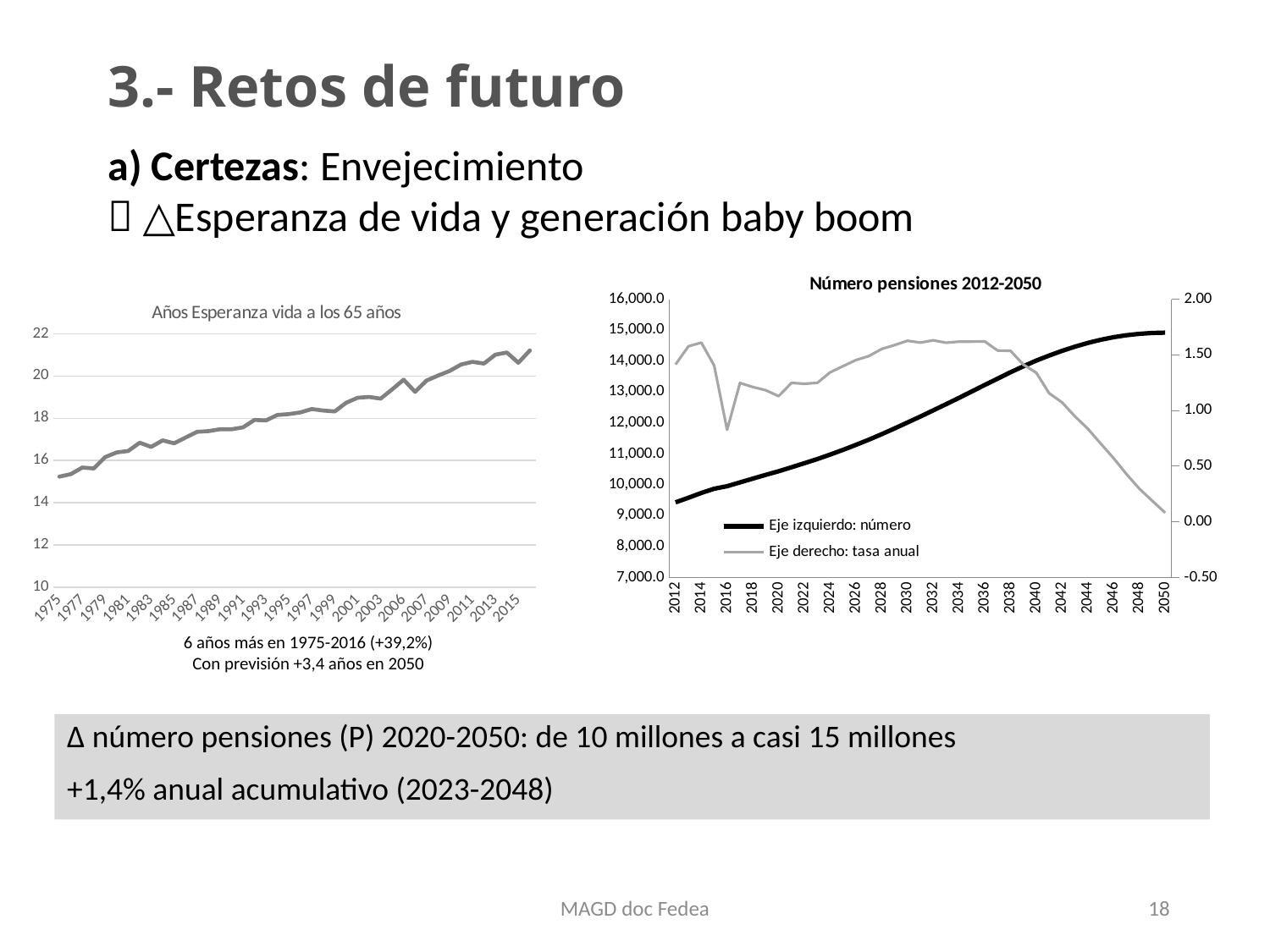
What kind of chart is the left chart titled 'Años Esperanza vida a los 65 años'? line chart How many series does the legend of the right chart 'Número pensiones 2012-2050' list? 2 In the right chart 'Número pensiones 2012-2050', is the value of 'Eje derecho: tasa anual' for 2050 greater or less than 0.50? less In the right chart 'Número pensiones 2012-2050', is the value of 'Eje izquierdo: número' for 2050 greater or less than 14,000.0? greater In the left chart 'Años Esperanza vida a los 65 años', which year has the lowest value, 1975 or 2015? 1975 In the right chart 'Número pensiones 2012-2050', which series is drawn with the thick black line? Eje izquierdo: número In the left chart 'Años Esperanza vida a los 65 años', do the values generally rise or fall from 1975 to 2015? rise In the right chart 'Número pensiones 2012-2050', is the value of 'Eje izquierdo: número' for 2012 greater or less than 10,000.0? less In the right chart 'Número pensiones 2012-2050', what are the two legend entries? Eje izquierdo: número; Eje derecho: tasa anual In the right chart 'Número pensiones 2012-2050', does the series 'Eje izquierdo: número' rise or fall from 2012 to 2050? rise